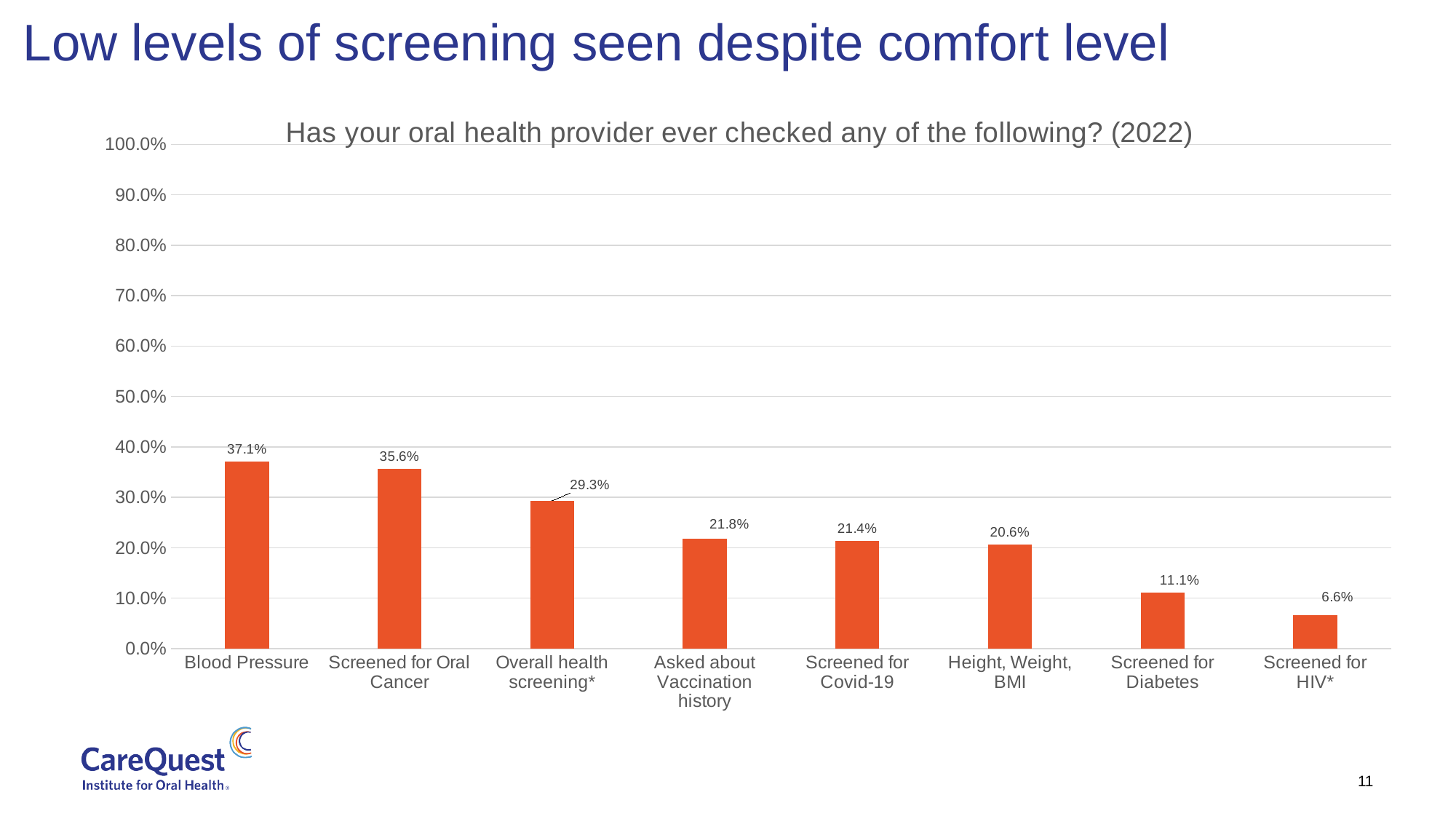
What is the difference between the values for 'Blood Pressure' and 'Screened for HIV*'? 30.5% What is the title of the chart? Has your oral health provider ever checked any of the following? (2022) Which is larger, the value for 'Screened for Covid-19' or the value for 'Screened for Diabetes'? Screened for Covid-19 Is the value for 'Height, Weight, BMI' greater or less than 30.0%? less How many categories are shown on the chart? 8 Which category has the highest value? Blood Pressure What is the difference between 'Screened for Oral Cancer' and 'Overall health screening*'? 6.3% What percentage of respondents said their oral health provider checked their blood pressure? 37.1% What kind of chart is shown on the slide? Bar chart What is the value for 'Screened for Diabetes'? 11.1% What is the value for 'Asked about Vaccination history'? 21.8% Which category has the lowest value? Screened for HIV*